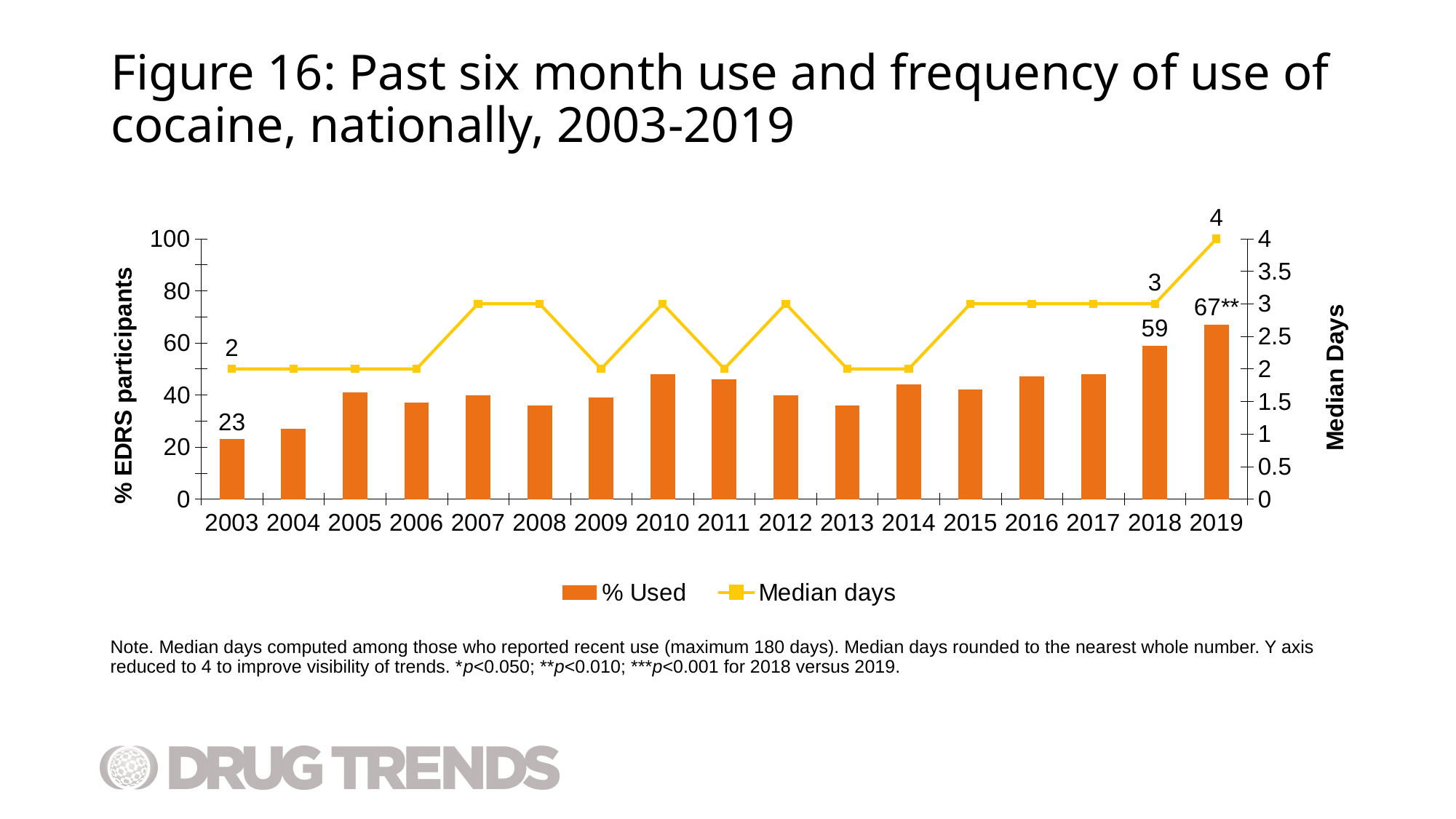
What is the Median days value for 2007? 3 Which year has the highest % Used value? 2019 What kind of chart is shown on the slide? Combined bar and line chart What is the Median days value for 2019? 4 Is the % Used value for 2010 greater or less than 40? greater What is the data label shown on the % Used bar for 2019? 67** What is the % Used value for 2018? 59 What is the difference between the % Used values for 2018 and 2003? 36 What is the % Used value for 2003? 23 Which year has the lowest % Used value? 2003 How many series does the legend list? 2 How many years are shown on the x axis? 17